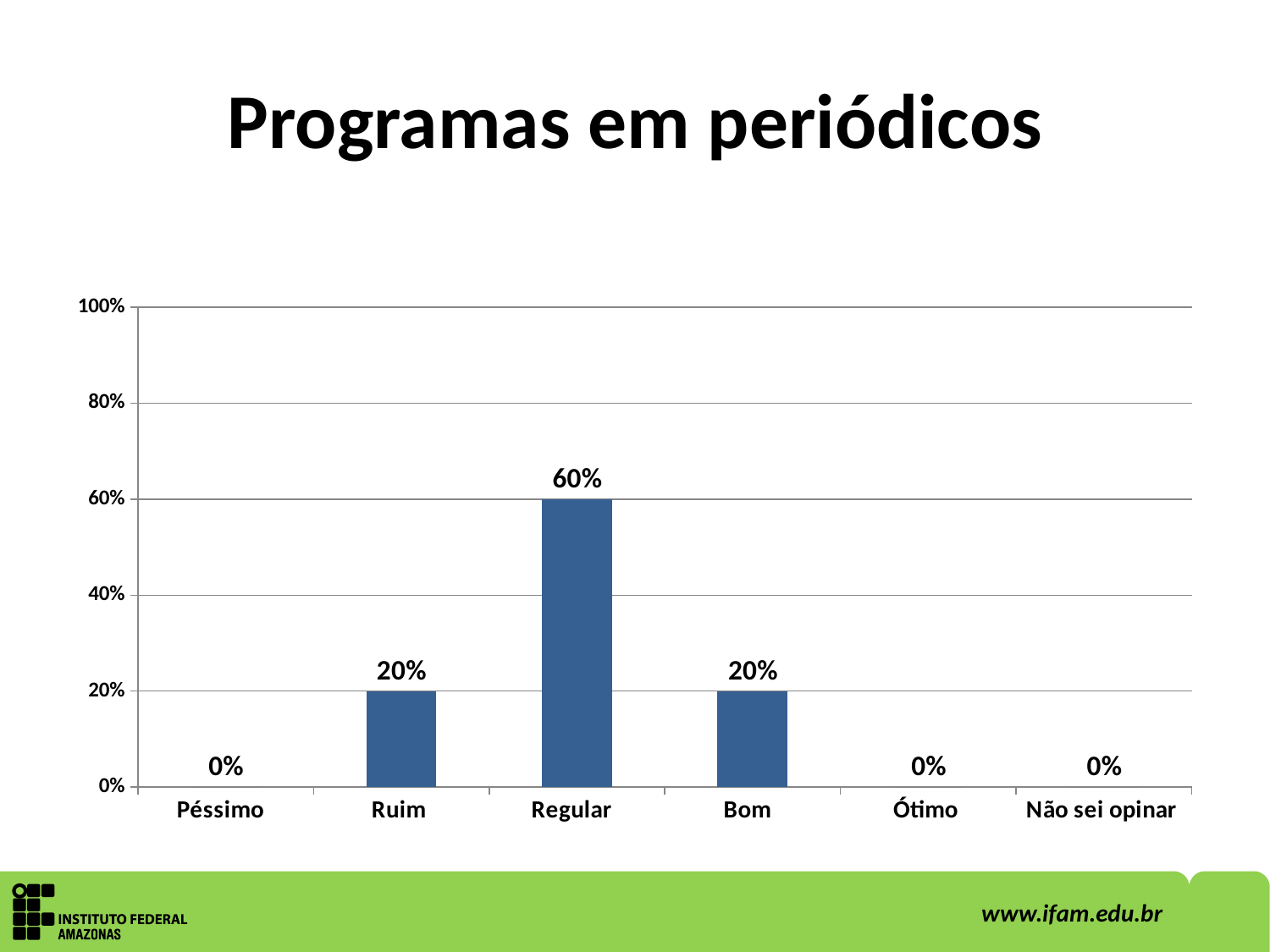
What is the value for Ruim? 20% What is the value for Não sei opinar? 0% What is the difference between the values for Regular and Bom? 40% What is the value for Ótimo? 0% What is the title of the slide? Programas em periódicos What is the value for Regular? 60% Is the value for Regular greater or less than 40%? greater Which is larger, the value for Regular or the value for Ruim? Regular Which category has the highest value? Regular How many categories are shown on the x axis? 6 How many categories have a value of 0%? 3 What kind of chart is shown on the slide? bar chart